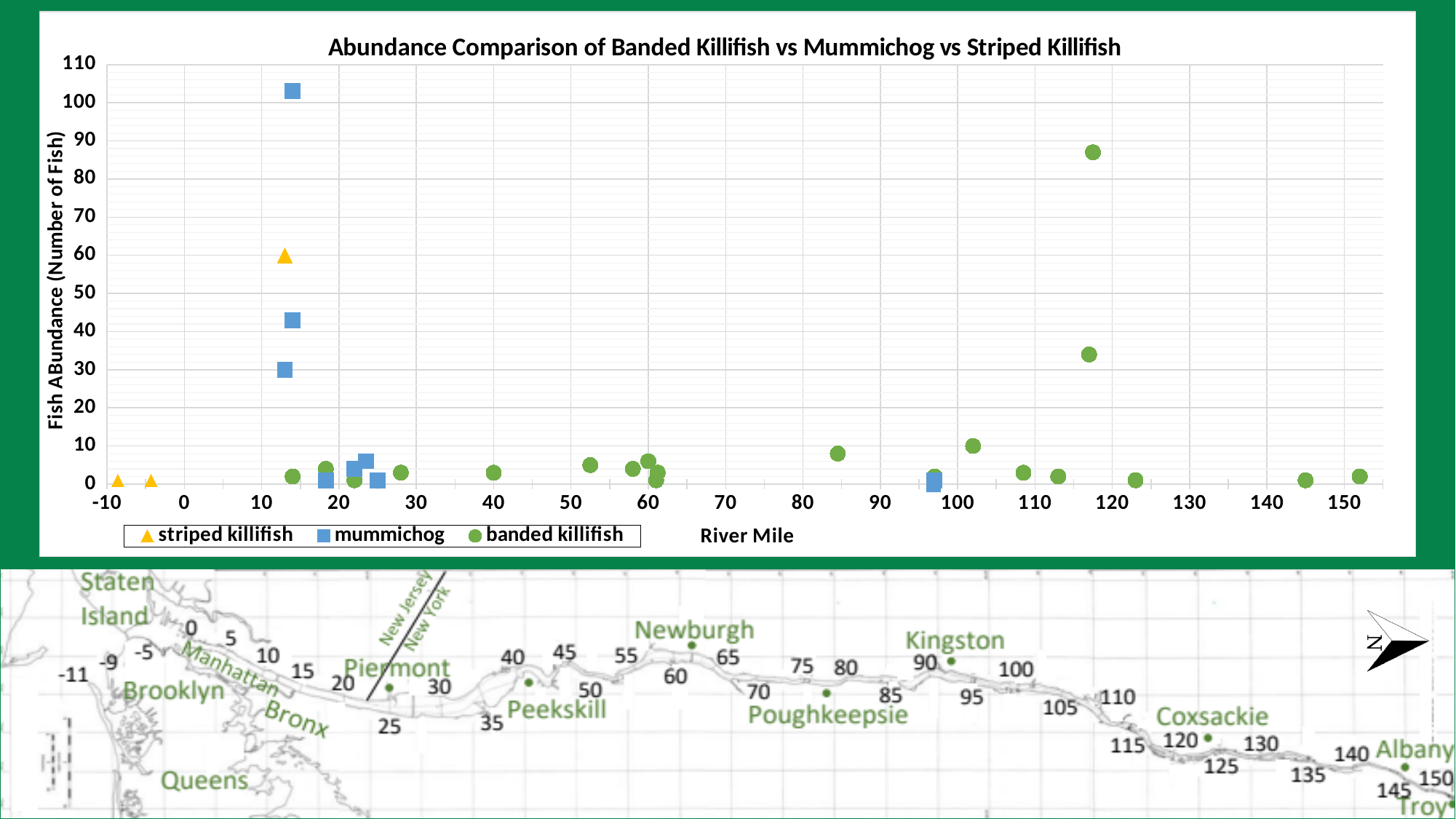
What is the title of the chart? Abundance Comparison of Banded Killifish vs Mummichog vs Striped Killifish Is the highest mummichog value greater or less than 90? greater What kind of chart is shown on the slide? scatter chart Is the highest striped killifish value greater or less than 50? greater Is the highest banded killifish value greater or less than 80? greater How many series does the legend list? 3 What is the label of the y axis? Fish ABundance (Number of Fish) Which is larger, the highest mummichog value or the highest banded killifish value? the highest mummichog value How many striped killifish points are plotted on the chart? 3 Which series has the single highest point on the chart? mummichog